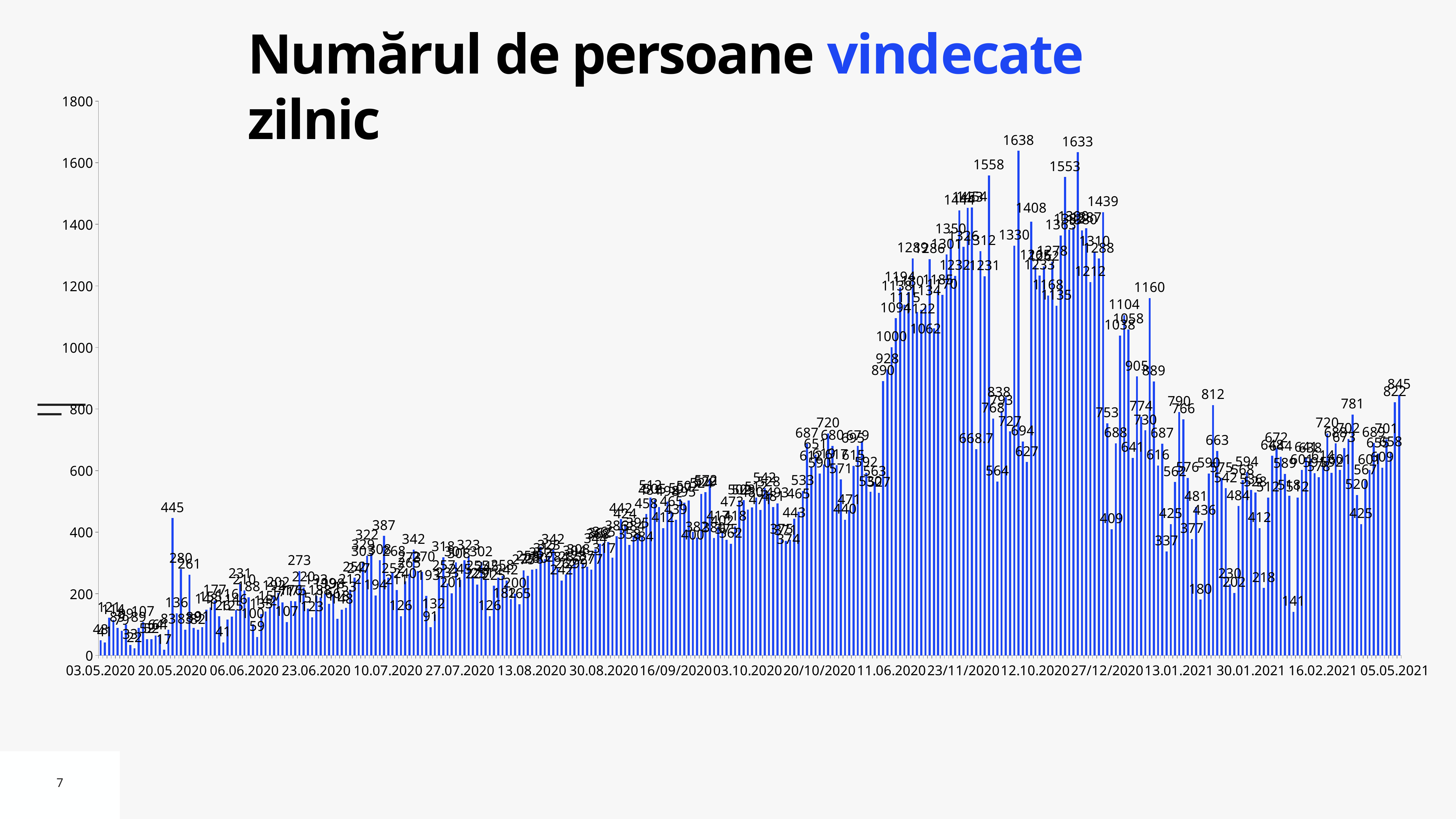
What is the value of the rightmost bar on the chart? 845 What is the value of the tallest bar between 03.05.2020 and 06.06.2020? 445 What is the highest value labeled on the chart? 1638 Do the values generally rise or fall from 03.05.2020 to 23/11/2020? rise Which is larger, the bar labeled 1558 or the bar labeled 1553? 1558 What is the title of the chart? Numărul de persoane vindecate zilnic Is the value of the first bar (03.05.2020) greater or less than 200? less What is the difference between the two tallest bars, labeled 1638 and 1633? 5 What is the maximum value shown on the vertical axis? 1800 What is the second-highest value labeled on the chart? 1633 What kind of chart is shown on the slide? bar chart What is the difference between the bars labeled 1638 and 1558? 80